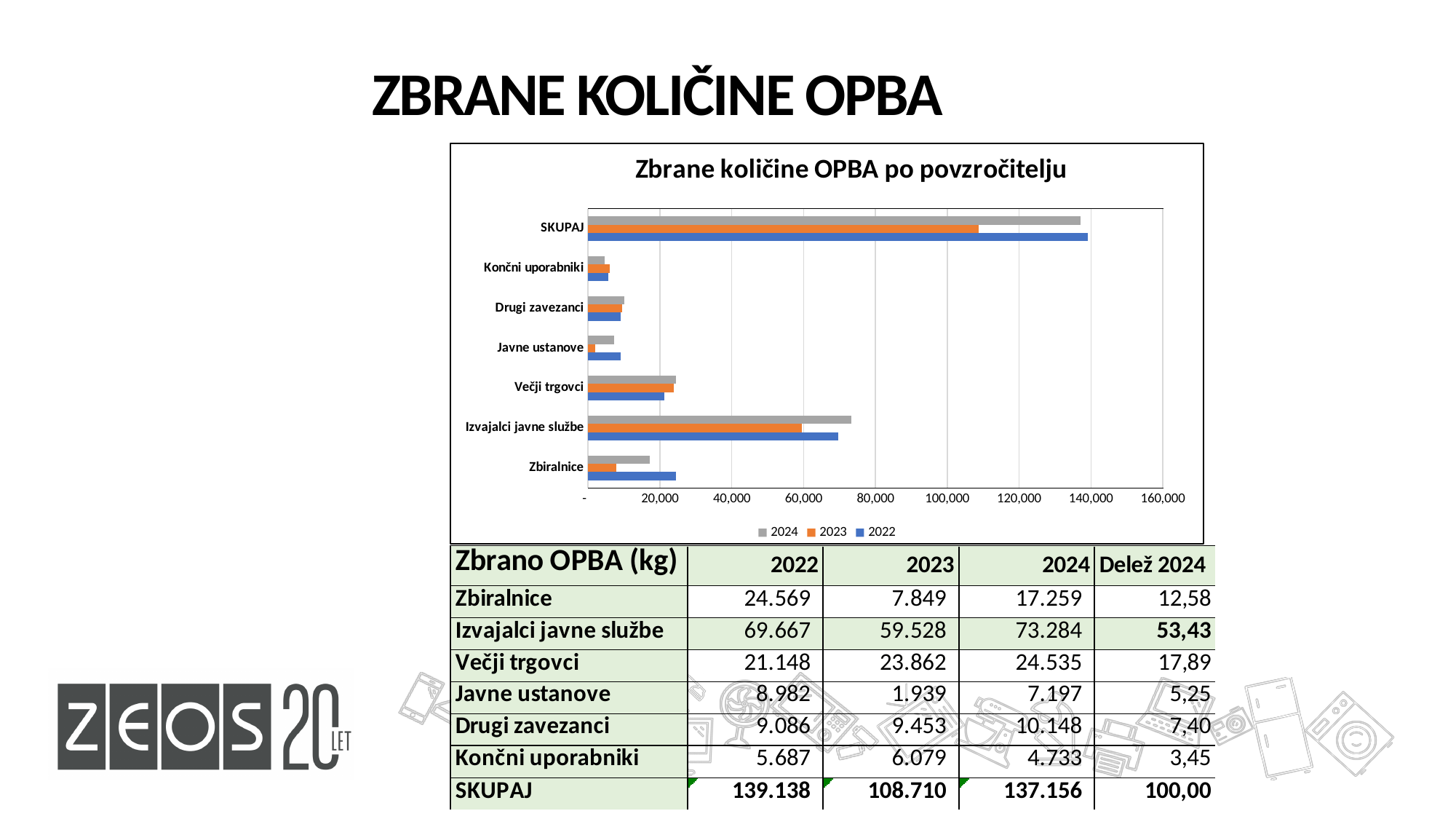
What share of the 2024 total does Izvajalci javne službe represent, according to the Delež 2024 column? 53,43 What kind of chart is shown on the slide? bar chart Which is larger for Zbiralnice: the 2022 value or the 2023 value? 2022 How many series does the chart legend list? 3 Is the 2024 value for Izvajalci javne službe greater or less than 80,000? less What is the difference between the SKUPAJ values for 2022 and 2023, using the table values? 30.428 Which category has the lowest 2023 value? Javne ustanove Is the 2023 value for SKUPAJ greater or less than 100,000? greater Excluding SKUPAJ, which category has the highest 2024 value? Izvajalci javne službe What is the title of the chart? Zbrane količine OPBA po povzročitelju How many categories are shown on the vertical axis of the chart? 7 What is the 2022 value for Zbiralnice, as printed in the table? 24.569